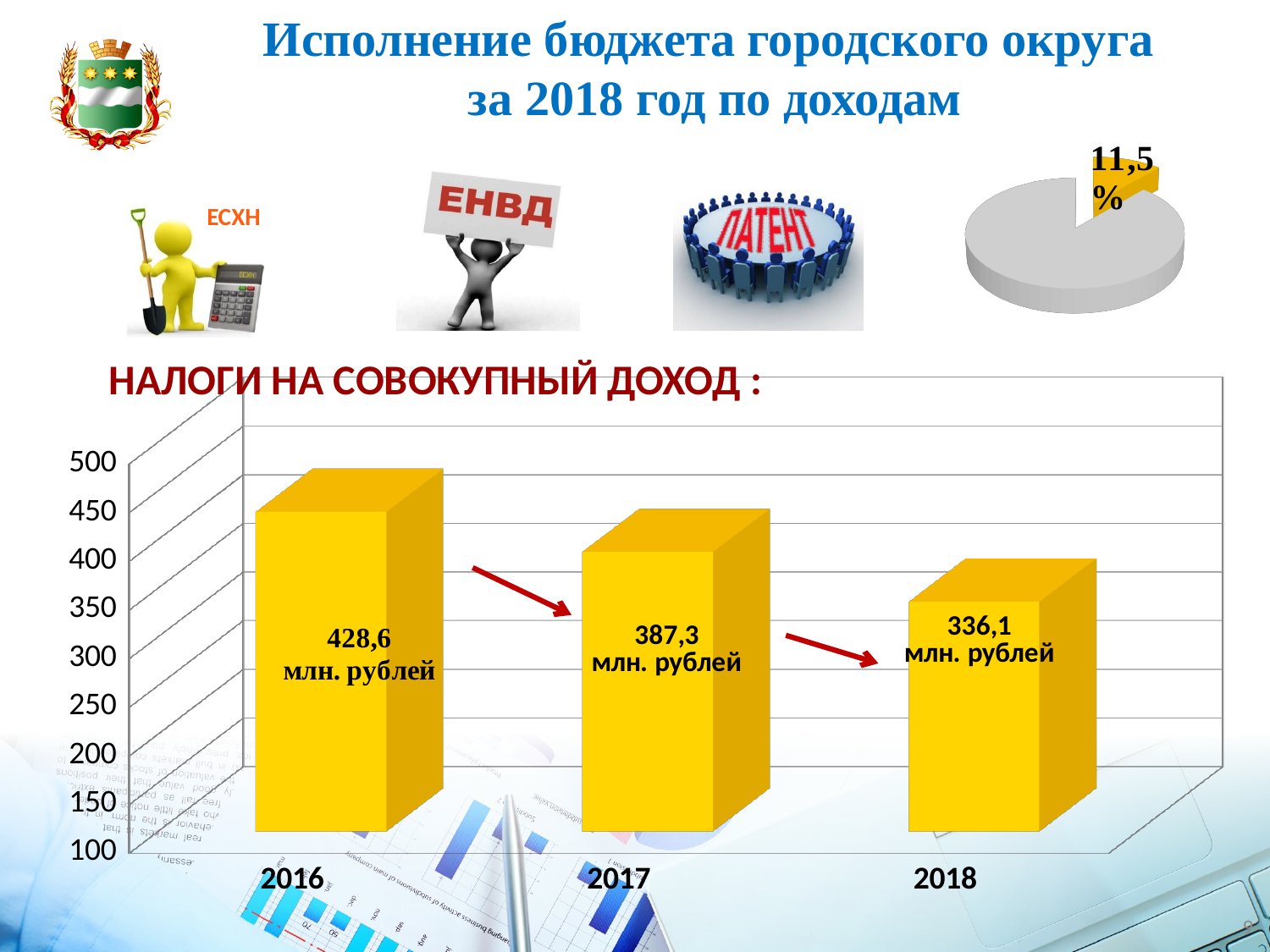
In the bar chart, is the value for 2018 greater or less than 350? less How many years are shown in the bar chart? 3 In the bar chart, what is the value for 2017? 387,3 млн. рублей In the bar chart, which is larger, the value for 2017 or the value for 2018? 2017 In the bar chart, which year has the highest value? 2016 In the bar chart, do the values rise or fall from 2016 to 2018? fall In the bar chart, which year has the lowest value? 2018 In the bar chart, what is the difference between the 2016 and 2017 values? 41,3 млн. рублей In the bar chart, what is the value for 2016? 428,6 млн. рублей In the bar chart, what is the value for 2018? 336,1 млн. рублей What kind of chart is the chart titled 'НАЛОГИ НА СОВОКУПНЫЙ ДОХОД'? bar chart In the bar chart, what is the difference between the 2017 and 2018 values? 51,2 млн. рублей